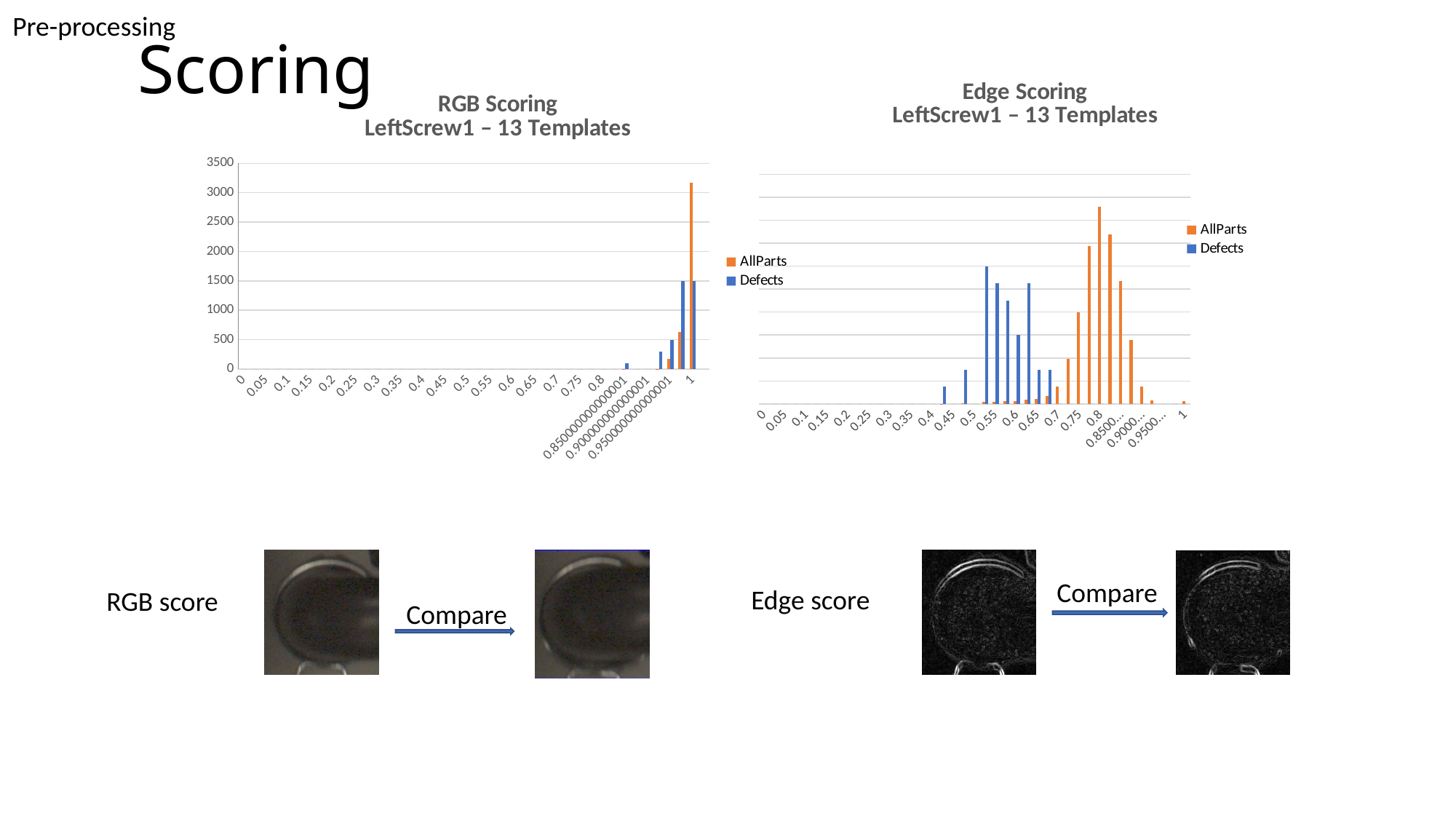
In the RGB Scoring chart, is the AllParts value at 1 greater or less than 3000? greater In the RGB Scoring chart, at which x-axis value is the tallest AllParts bar? 1 In the RGB Scoring chart, which colour represents the Defects series? blue What is the highest value shown on the y-axis of the RGB Scoring chart? 3500 In the Edge Scoring chart, which is larger: the tallest AllParts bar or the tallest Defects bar? the tallest AllParts bar What kind of chart is the RGB Scoring chart? bar chart How many series does the legend of the Edge Scoring chart list? 2 In the RGB Scoring chart, is the Defects value at 1 greater or less than 1000? greater What are the two series named in the legend of the RGB Scoring chart? AllParts and Defects In the Edge Scoring chart, at which x-axis value is the tallest AllParts bar? 0.8 In the RGB Scoring chart, which series has the larger value at x = 1, AllParts or Defects? AllParts